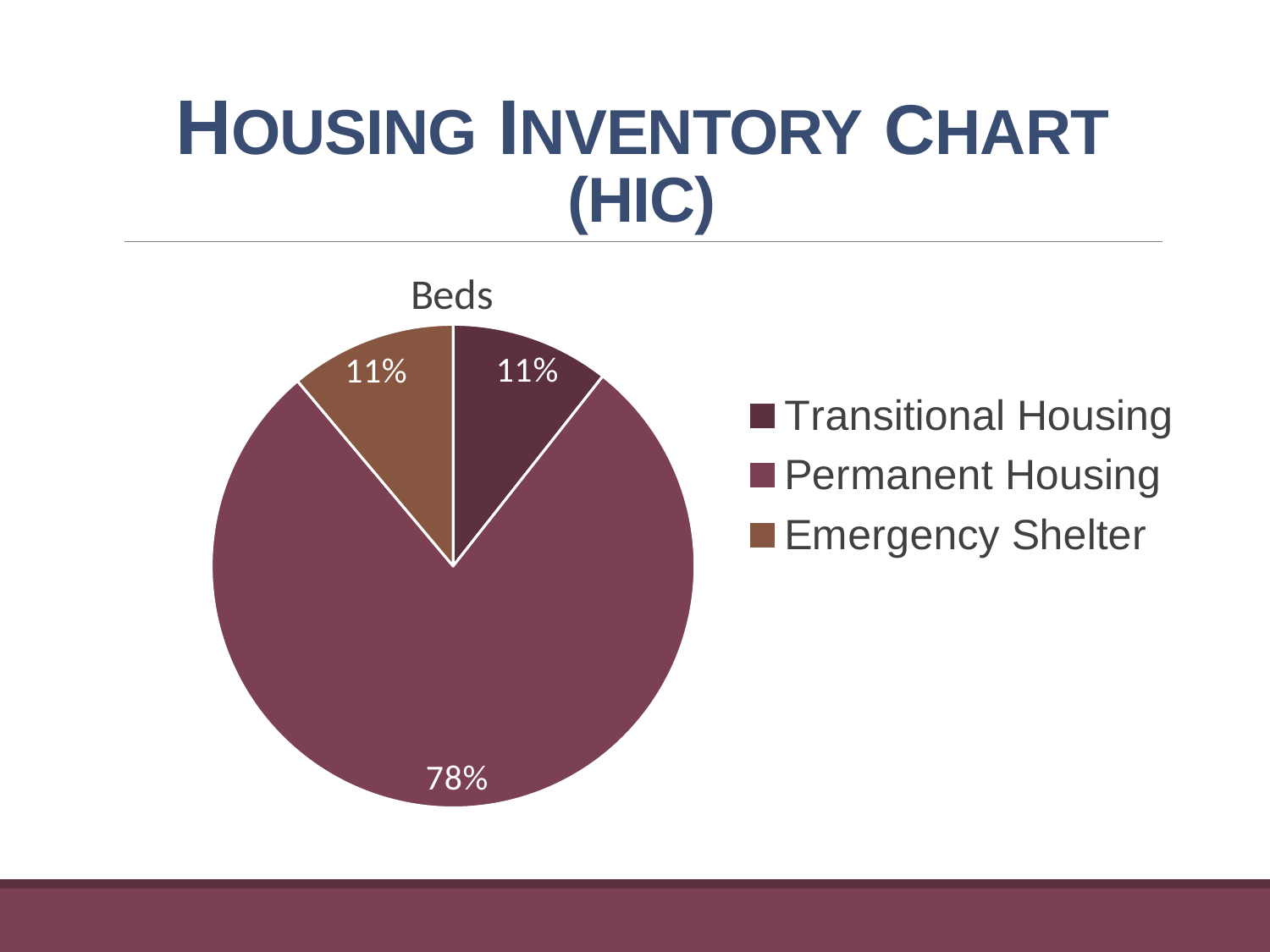
What is the title of the chart? Beds What is the combined share of Transitional Housing and Emergency Shelter? 22% What share of beds is Transitional Housing? 11% What share of beds is Permanent Housing? 78% What kind of chart is shown on the slide? pie chart How many categories does the pie chart show? 3 Which category has the largest share of beds? Permanent Housing Which legend entry is shown in brown? Emergency Shelter How many entries does the legend list? 3 What is the difference in percentage points between the Permanent Housing share and the Emergency Shelter share? 67 Which is larger, the share for Permanent Housing or the share for Transitional Housing? Permanent Housing What share of beds is Emergency Shelter? 11%